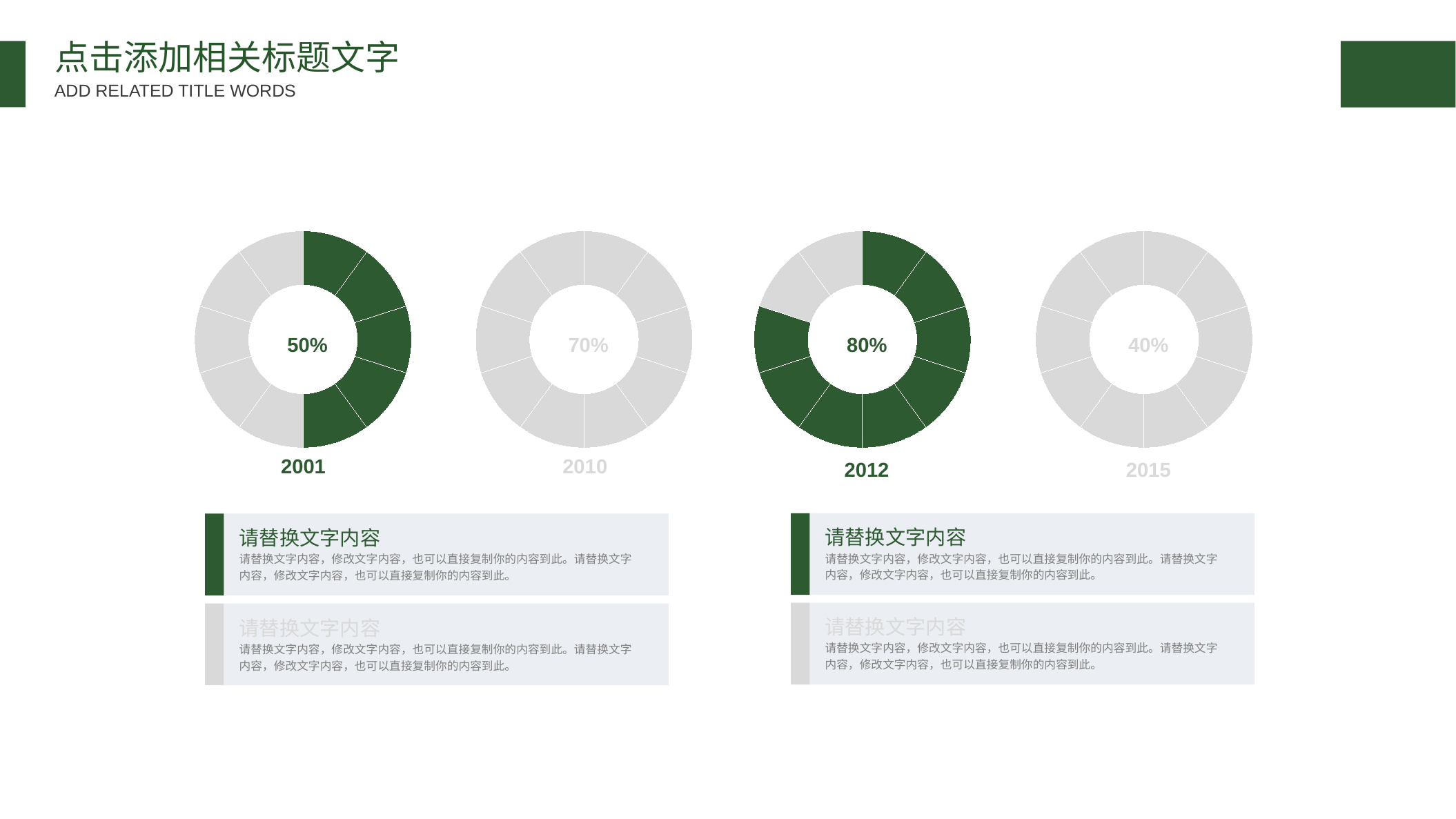
In the donut chart labelled 2012, what colour are the filled segments? Dark green Which year's donut chart shows the highest percentage? 2012 How many donut charts are on the slide? 4 What percentage is shown in the centre of the donut chart labelled 2015? 40% What percentage is shown in the centre of the donut chart labelled 2010? 70% How many segments does the donut chart labelled 2001 have? 10 What is the difference between the percentage shown for 2012 and the percentage shown for 2001? 30% What percentage is shown in the centre of the donut chart labelled 2001? 50% What percentage is shown in the centre of the donut chart labelled 2012? 80% Which year's donut chart shows the lowest percentage? 2015 What kind of chart is used to show the percentage for each year? Donut chart Which shows a larger percentage, the 2010 donut chart or the 2015 donut chart? 2010